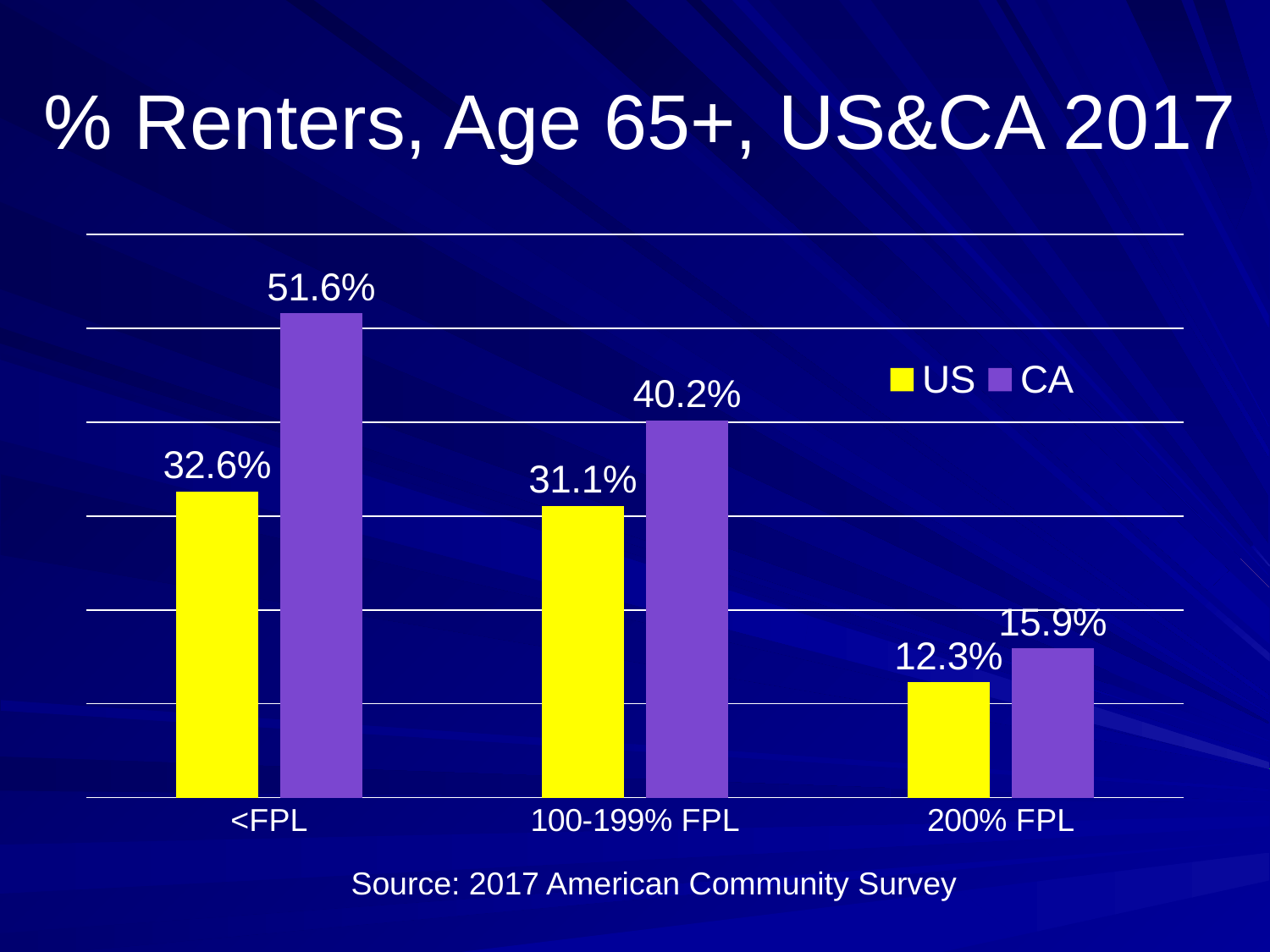
Which category has the highest CA value? <FPL Do the CA values rise or fall from <FPL to 200% FPL? Fall What is the difference between the CA and US values for the <FPL category? 19.0% How many categories are shown on the x axis? 3 What is the difference between the CA and US values for the 200% FPL category? 3.6% What is the CA value for the 100-199% FPL category? 40.2% What is the CA value for the 200% FPL category? 15.9% Which is larger for the 100-199% FPL category, the US value or the CA value? CA Which category has the lowest US value? 200% FPL What is the US value for the <FPL category? 32.6% What kind of chart is shown on the slide? Bar chart How many series does the legend list? 2